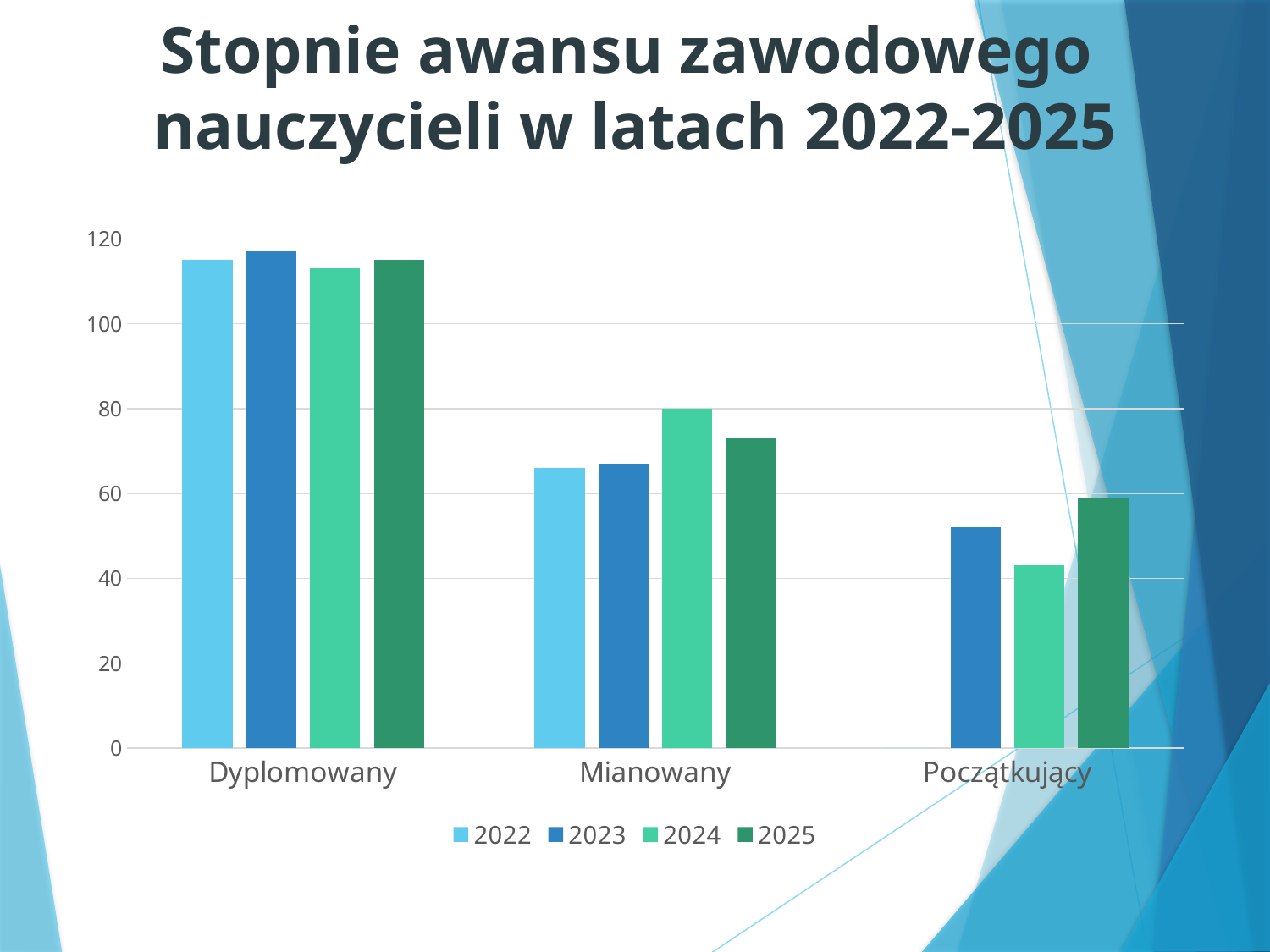
Which is larger for Początkujący: the value for 2023 or the value for 2024? 2023 Which category has the highest value for 2024? Dyplomowany What is the title of the chart? Stopnie awansu zawodowego nauczycieli w latach 2022-2025 How many categories are shown on the x axis? 3 Is the value for Dyplomowany in 2023 greater or less than 100? greater Is the value for Mianowany in 2024 greater or less than 60? greater Is the value for Początkujący in 2024 greater or less than 60? less What kind of chart is shown on the slide? bar chart Which year has the highest value in the Mianowany category? 2024 Which is larger for Mianowany: the value for 2022 or the value for 2024? 2024 How many series does the legend list? 4